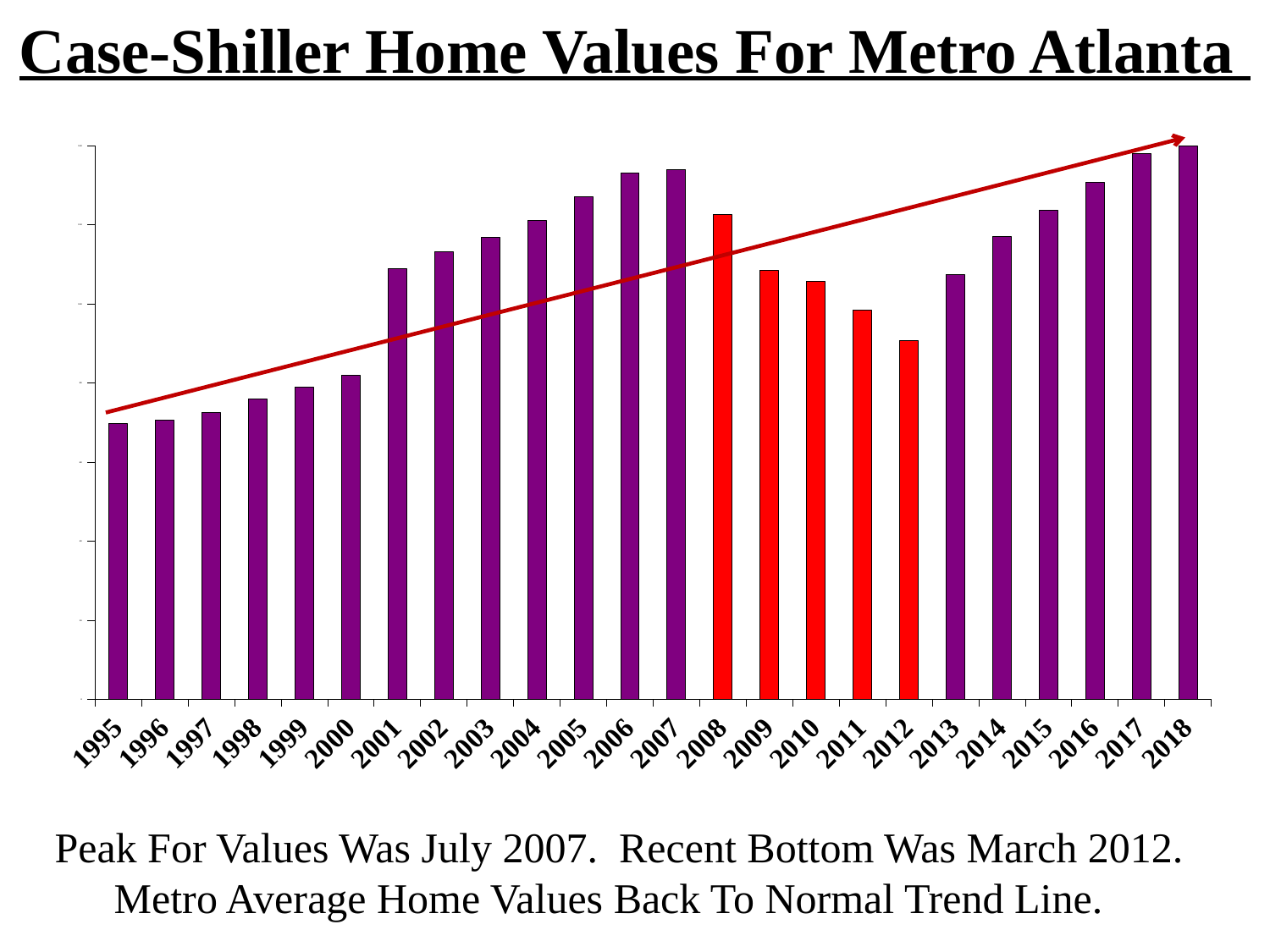
Which year has the highest value between 2001 and 2007? 2007 Which is larger, the value for 2001 or the value for 2000? 2001 Which years are shown with red bars? 2008 to 2012 Which year has the lowest value among the red bars? 2012 Do the values rise or fall from 2008 to 2012? fall Do the values rise or fall from 1995 to 2007? rise What is the title of the slide's chart? Case-Shiller Home Values For Metro Atlanta What kind of chart is shown on the slide? bar chart How many years (bars) are plotted on the chart? 24 Is the value for 2007 larger or smaller than the value for 2012? larger Which is larger, the value for 2011 or the value for 2012? 2011 How many bars are coloured red rather than purple? 5